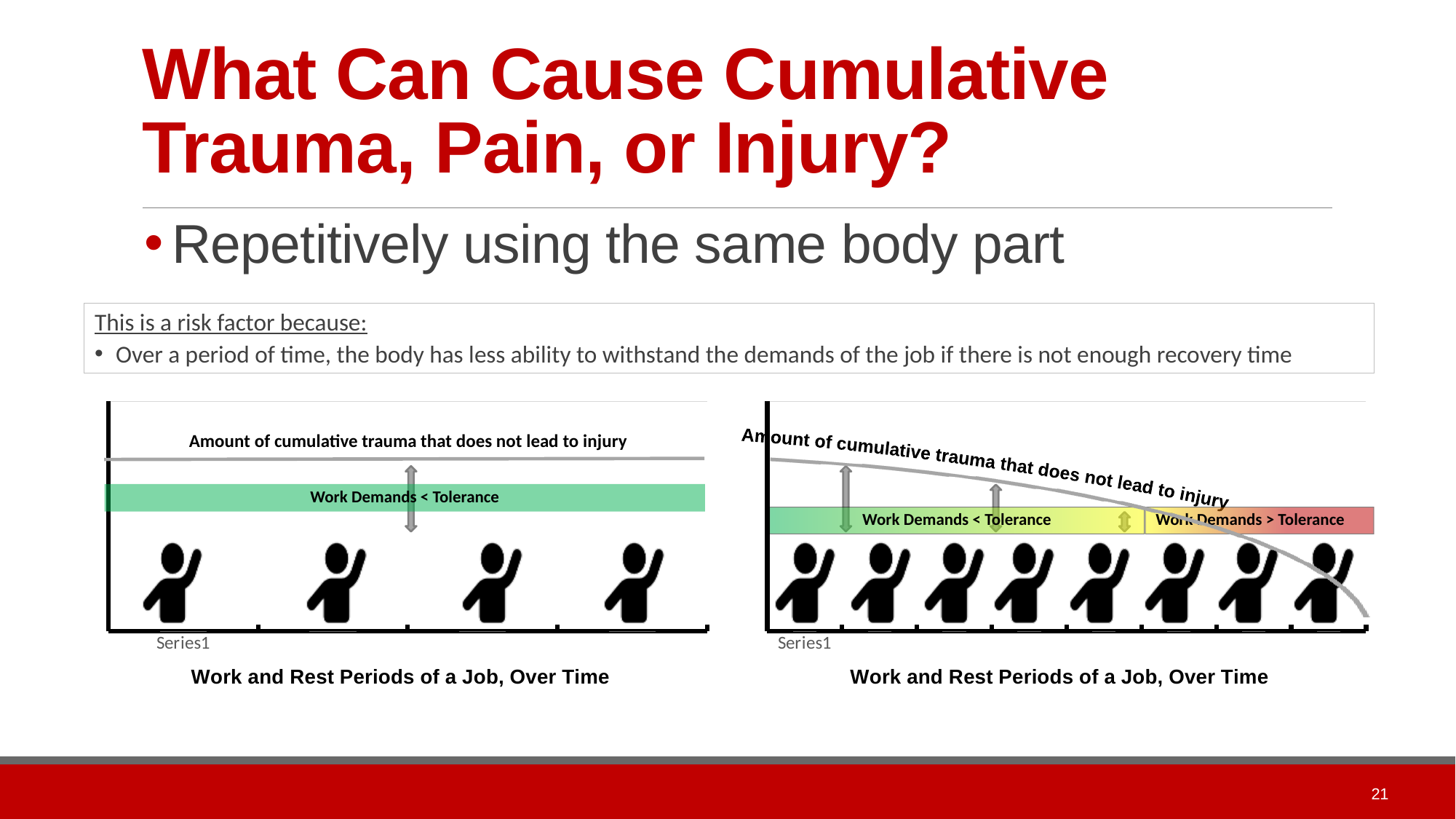
In the left chart, how many person figures are shown along the x axis? 4 In the right chart, how many person figures are shown along the x axis? 8 In the right chart, what label appears on the red section of the band? Work Demands > Tolerance In the right chart, does the line labelled 'Amount of cumulative trauma that does not lead to injury' rise, fall, or stay flat along the x axis? fall In the left chart, does the line labelled 'Amount of cumulative trauma that does not lead to injury' rise, fall, or stay flat along the x axis? stay flat What is the x-axis category label shown at the bottom left of each chart? Series1 What is the title shown beneath the left chart? Work and Rest Periods of a Job, Over Time Which chart shows more person figures, the left chart or the right chart? the right chart